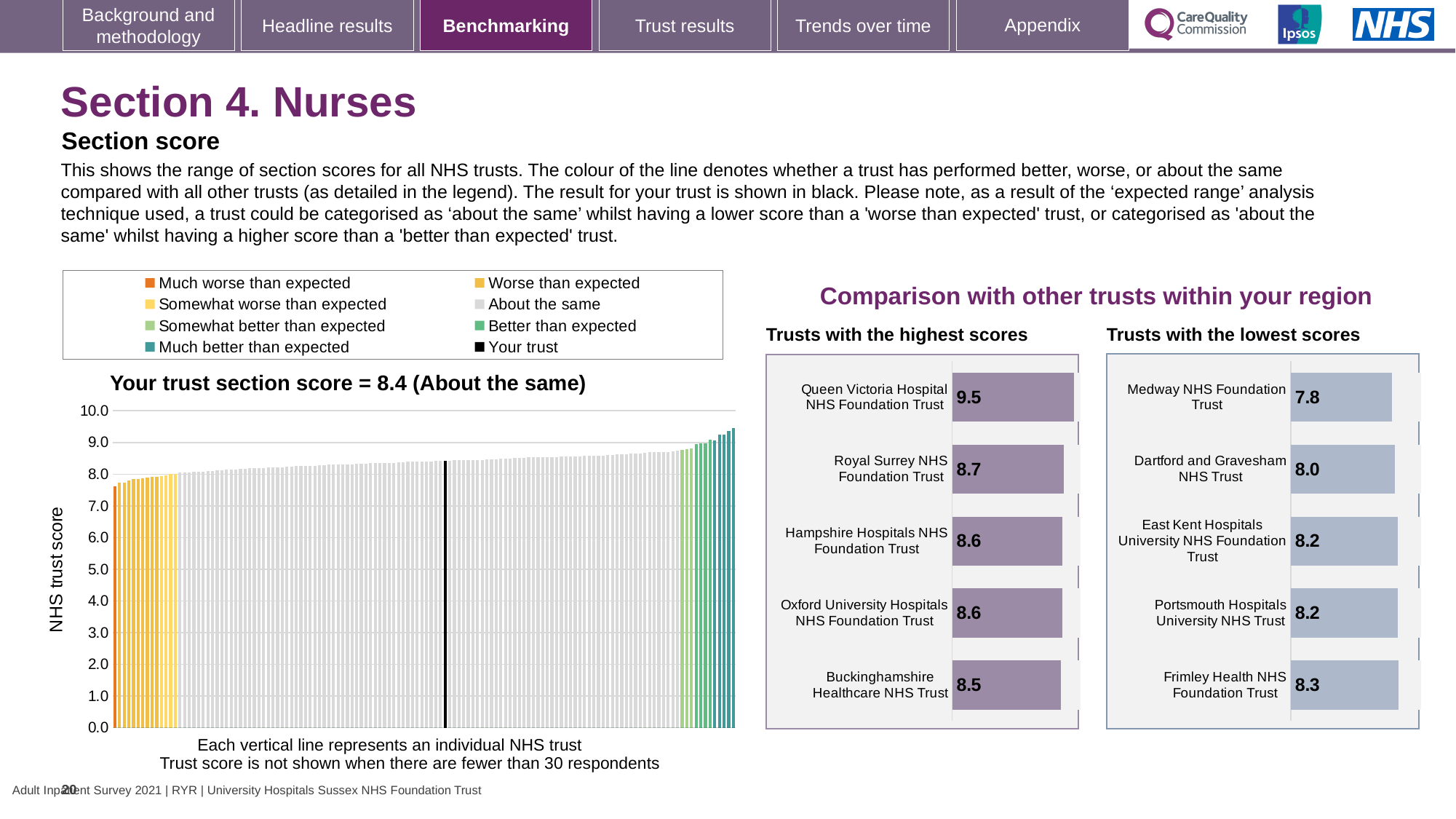
In the 'Trusts with the lowest scores' chart, which trust has the lowest score? Medway NHS Foundation Trust In the 'Your trust section score' chart, what is the section score for your trust? 8.4 In the 'Trusts with the lowest scores' chart, what is the score for Medway NHS Foundation Trust? 7.8 In the 'Trusts with the lowest scores' chart, what is the difference between the scores of Frimley Health NHS Foundation Trust and Medway NHS Foundation Trust? 0.5 In the 'Your trust section score' chart, how many entries does the legend list? 8 In the 'Your trust section score' chart, is the value of the lowest-scoring trust (leftmost bar) greater or less than 8.0? less In the 'Trusts with the highest scores' chart, what is the score for Queen Victoria Hospital NHS Foundation Trust? 9.5 In the 'Your trust section score' chart, what is the label on the vertical axis? NHS trust score In the 'Trusts with the highest scores' chart, how many trusts are shown? 5 In the 'Trusts with the highest scores' chart, what is the difference between the scores of Queen Victoria Hospital NHS Foundation Trust and Buckinghamshire Healthcare NHS Trust? 1.0 In the 'Trusts with the highest scores' chart, which trust has the highest score? Queen Victoria Hospital NHS Foundation Trust In the 'Your trust section score' chart, what kind of chart is shown? bar chart